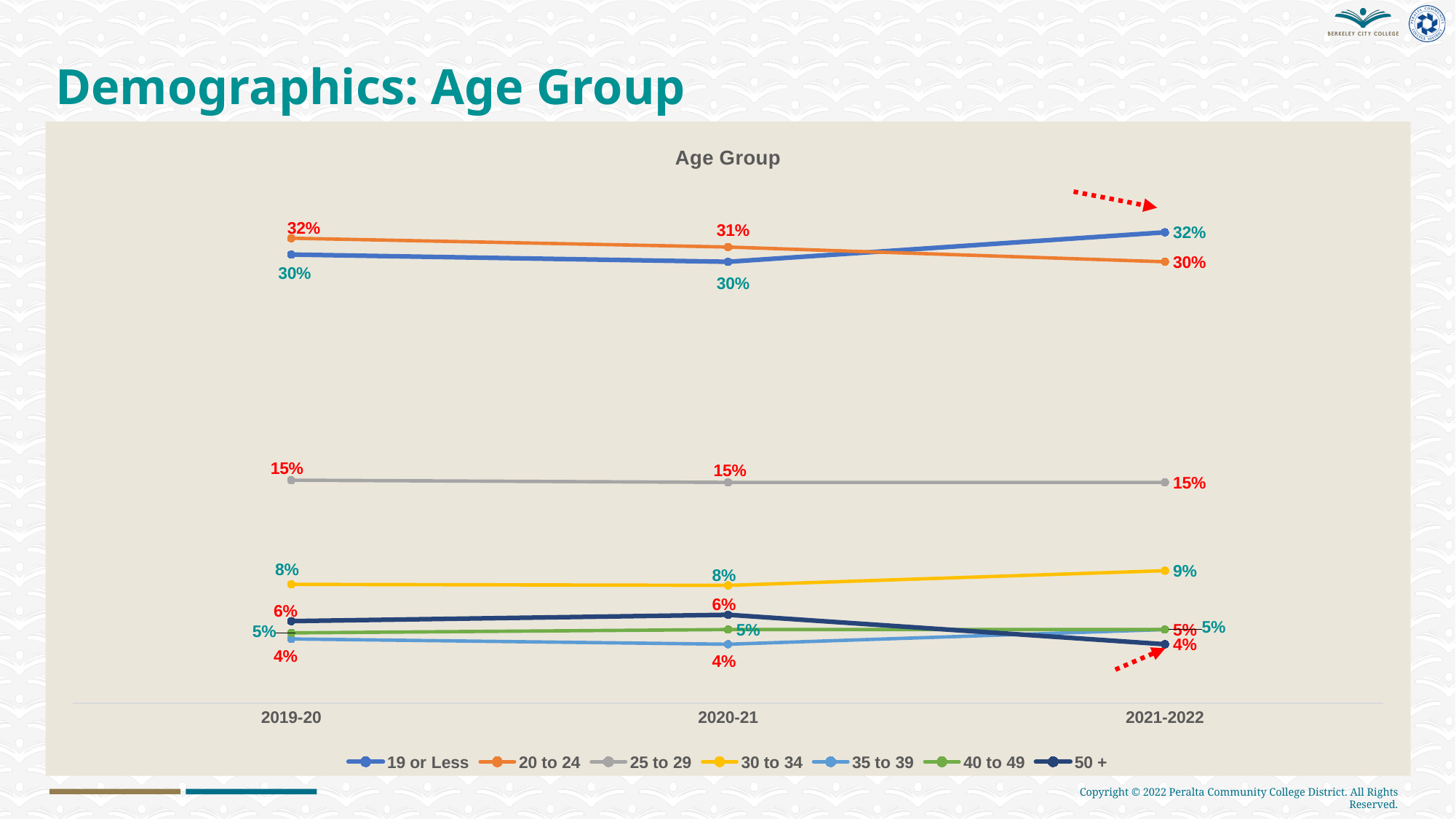
What kind of chart is shown on the slide? Line chart What is the value for the 30 to 34 group in 2021-2022? 9% What is the value for the 19 or Less group in 2021-2022? 32% Does the value for the 20 to 24 group rise or fall from 2019-20 to 2021-2022? Fall Which age group has the highest value in 2019-20? 20 to 24 What is the value for the 25 to 29 group in 2020-21? 15% How many academic years are shown on the x axis of the Age Group chart? 3 How many series does the legend of the Age Group chart list? 7 What is the value for the 50 + group in 2021-2022? 4% What is the value for the 20 to 24 group in 2019-20? 32% Which age group has the highest value in 2021-2022? 19 or Less In 2021-2022, how much higher is the 19 or Less group than the 20 to 24 group? 2 percentage points